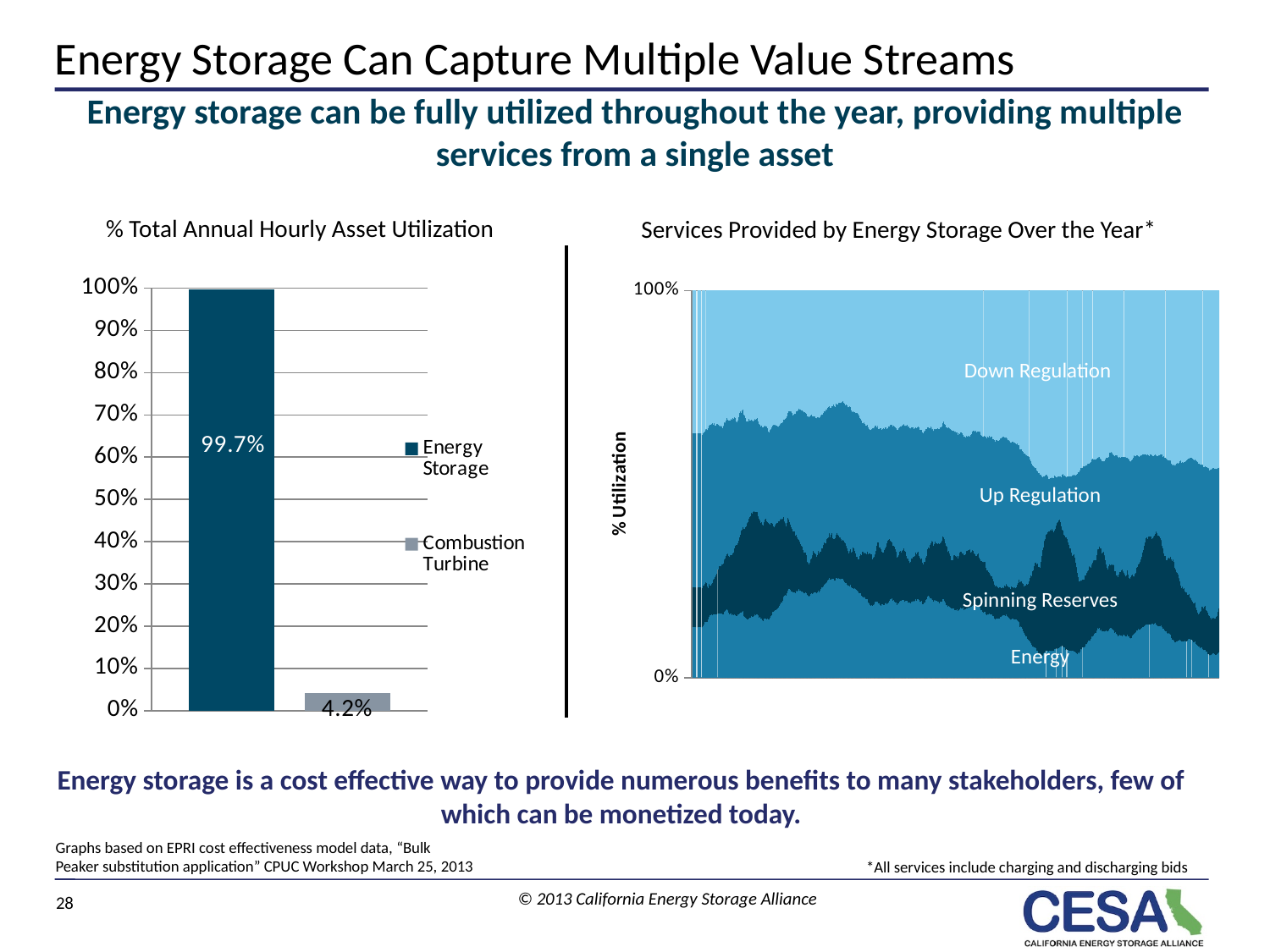
In the '% Total Annual Hourly Asset Utilization' chart, what is the value for Combustion Turbine? 4.2% In the '% Total Annual Hourly Asset Utilization' chart, which series has the lowest value? Combustion Turbine In the '% Total Annual Hourly Asset Utilization' chart, what is the difference between the Energy Storage and Combustion Turbine values? 95.5% What kind of chart is the '% Total Annual Hourly Asset Utilization' chart? bar chart In the 'Services Provided by Energy Storage Over the Year*' chart, which service is shown at the top of the stack? Down Regulation In the '% Total Annual Hourly Asset Utilization' chart, how many series does the legend list? 2 In the '% Total Annual Hourly Asset Utilization' chart, which series has the highest value? Energy Storage In the 'Services Provided by Energy Storage Over the Year*' chart, how many services are labeled in the plot area? 4 What is the y-axis label of the 'Services Provided by Energy Storage Over the Year*' chart? % Utilization In the '% Total Annual Hourly Asset Utilization' chart, is the value for Combustion Turbine greater or less than 10%? less In the '% Total Annual Hourly Asset Utilization' chart, what is the value for Energy Storage? 99.7% In the 'Services Provided by Energy Storage Over the Year*' chart, what is the maximum value shown on the y axis? 100%